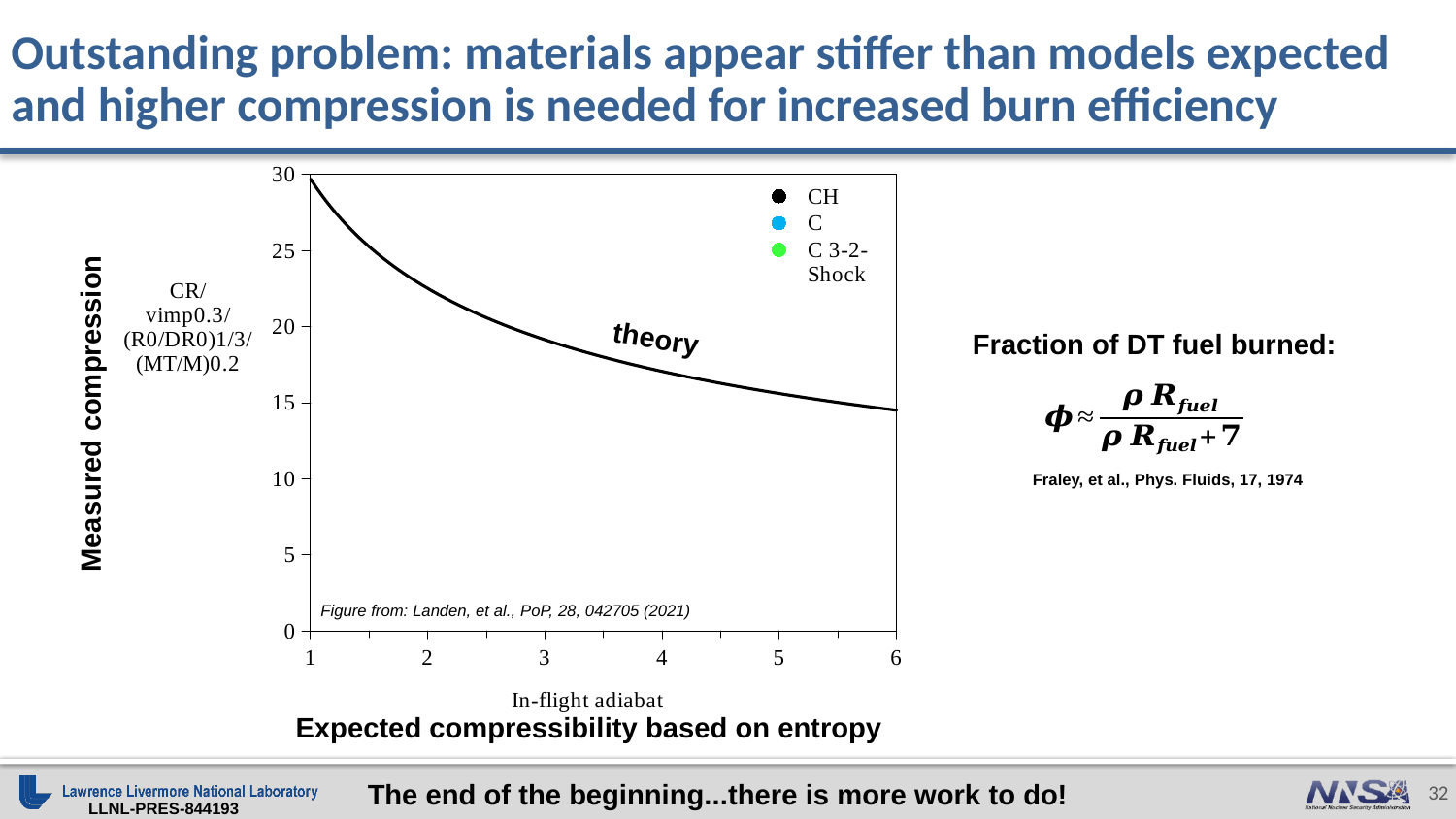
Is the value of the theory curve at an in-flight adiabat of 1 greater or less than 25? greater How many entries does the legend list? 3 What kind of chart is shown on the slide? line chart Is the value of the theory curve at an in-flight adiabat of 2 greater or less than 15? greater What are the three entries listed in the chart legend? CH, C, C 3-2-Shock Does the theory curve rise or fall as the in-flight adiabat increases from 1 to 6? fall Is the value of the theory curve at an in-flight adiabat of 4 greater or less than 20? less Is the theory curve higher at an in-flight adiabat of 2 or at an in-flight adiabat of 5? 2 What is the label of the x axis of the chart? In-flight adiabat